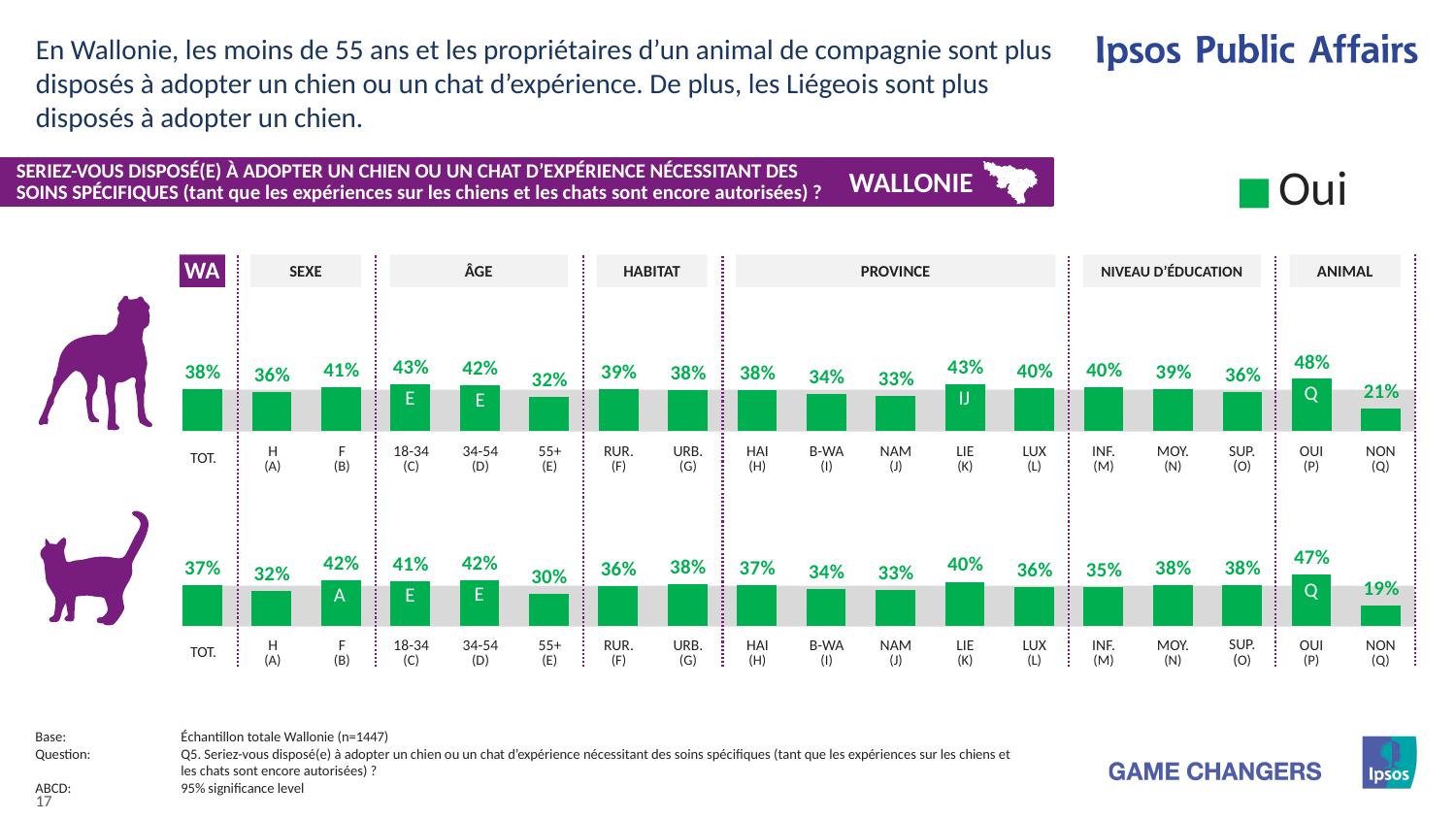
In the cat chart (bottom row), which category has the lowest value? NON (non pet owners), 19% In the dog chart (top row), what is the difference between the values for OUI and NON under ANIMAL? 27 percentage points In the cat chart (bottom row), which is larger: the value for H (men) or F (women)? F (women), 42% What response does the green colour in the legend represent? Oui In the cat chart (bottom row), what is the difference between the values for 18-34 and 55+? 11 percentage points In the dog chart (top row), which category has the highest value? OUI (pet owners), 48% What type of chart is used to show the results on this slide? Bar chart In the cat chart (bottom row), what is the value for the 55+ age group? 30% In the dog chart (top row), what is the value for TOT. (total Wallonia)? 38% In the dog chart (top row), what is the value for LIE (Liège)? 43% How many categories (bars) are shown in the dog chart (top row)? 18 In the dog chart (top row), do the values rise or fall across the age groups from 18-34 to 55+? Fall